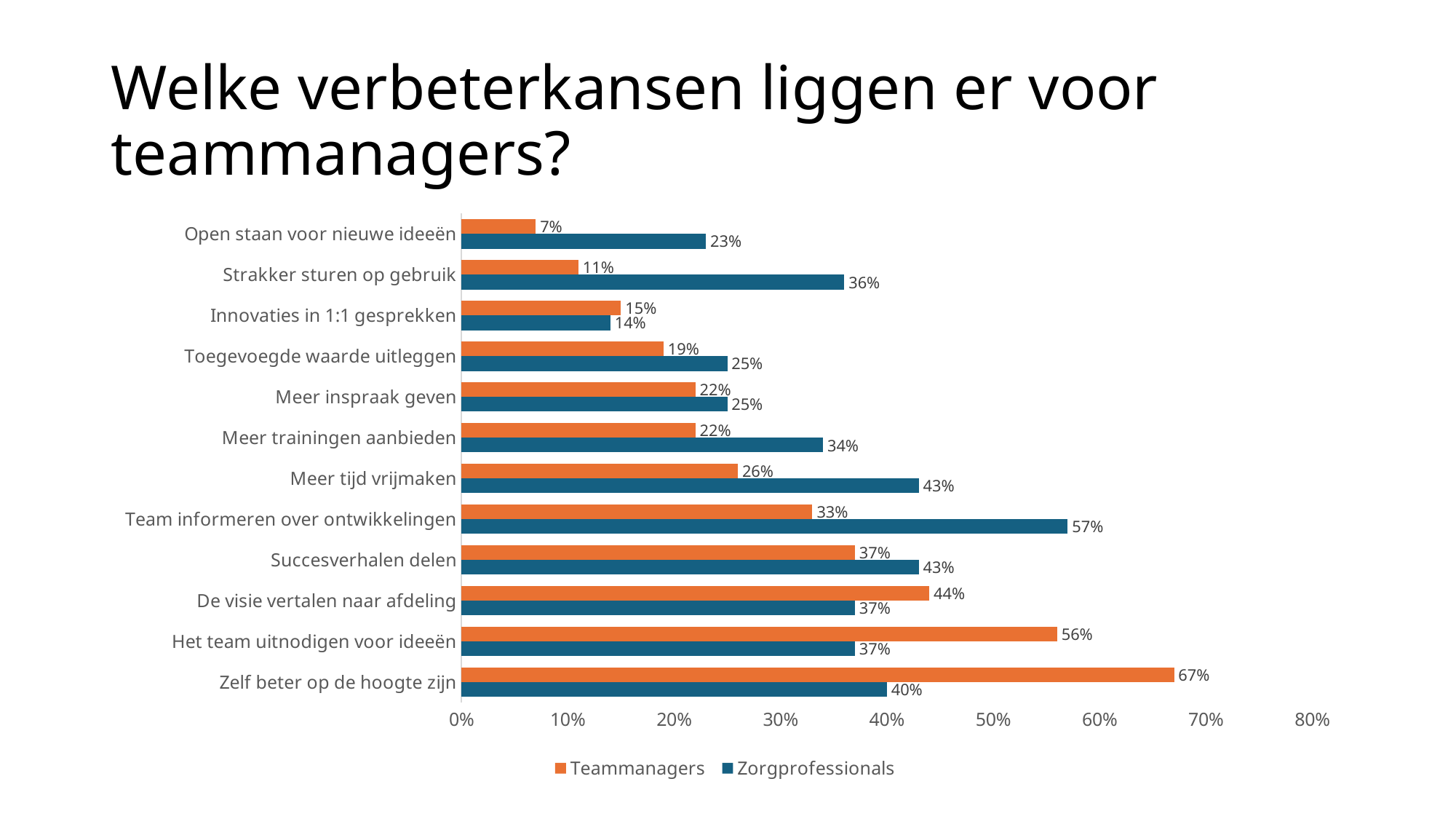
Which category has the lowest Teammanagers value? Open staan voor nieuwe ideeën For 'Het team uitnodigen voor ideeën', which series has the larger value, Teammanagers or Zorgprofessionals? Teammanagers Which colour represents the Zorgprofessionals series? Blue What is the Zorgprofessionals value for 'Team informeren over ontwikkelingen'? 57% How many categories are shown on the chart? 12 Which category has the highest Zorgprofessionals value? Team informeren over ontwikkelingen What is the difference between the Zorgprofessionals and Teammanagers values for 'Team informeren over ontwikkelingen'? 24% What kind of chart is shown on the slide? Bar chart Which category has the highest Teammanagers value? Zelf beter op de hoogte zijn How many series does the legend list? 2 What is the Teammanagers value for 'Zelf beter op de hoogte zijn'? 67% What is the Zorgprofessionals value for 'Strakker sturen op gebruik'? 36%